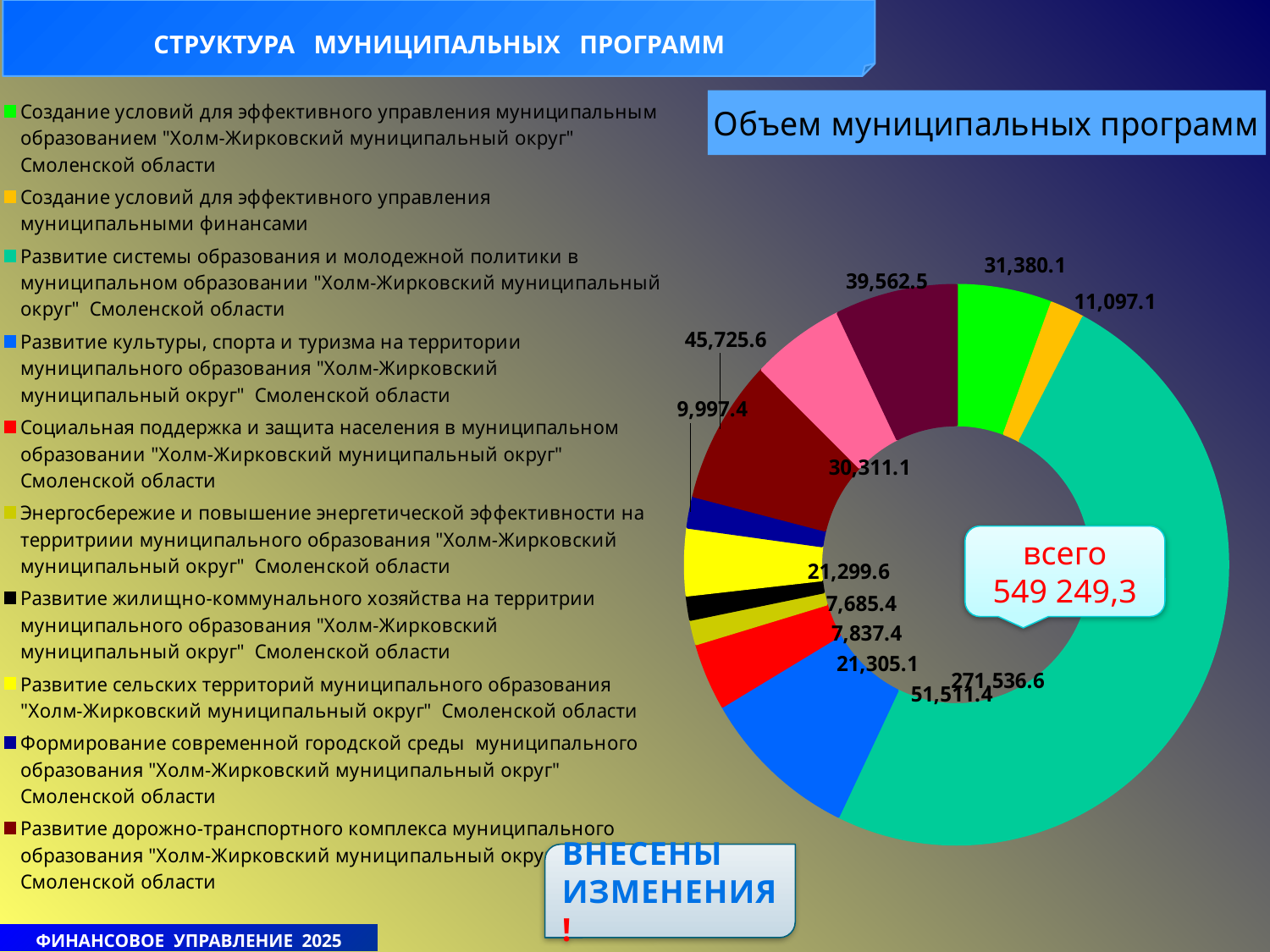
What is the value for "Формирование современной городской среды"? 9,997.4 What is the value for "Развитие культуры, спорта и туризма"? 51,511.4 What total ("всего") is shown in the centre of the chart? 549 249,3 Which program has the largest value in the chart? Развитие системы образования и молодежной политики Which is larger: the value for "Социальная поддержка и защита населения" or for "Развитие сельских территорий"? Социальная поддержка и защита населения How many slices does the chart have? 12 What is the difference between the values for "Развитие культуры, спорта и туризма" and "Создание условий для эффективного управления муниципальным образованием"? 20,131.3 Which program has the smallest value in the chart? Развитие жилищно-коммунального хозяйства What is the value for "Развитие дорожно-транспортного комплекса"? 45,725.6 What is the value for "Развитие системы образования и молодежной политики"? 271,536.6 What kind of chart is shown on the slide? doughnut chart What is the title of the chart? Объем муниципальных программ